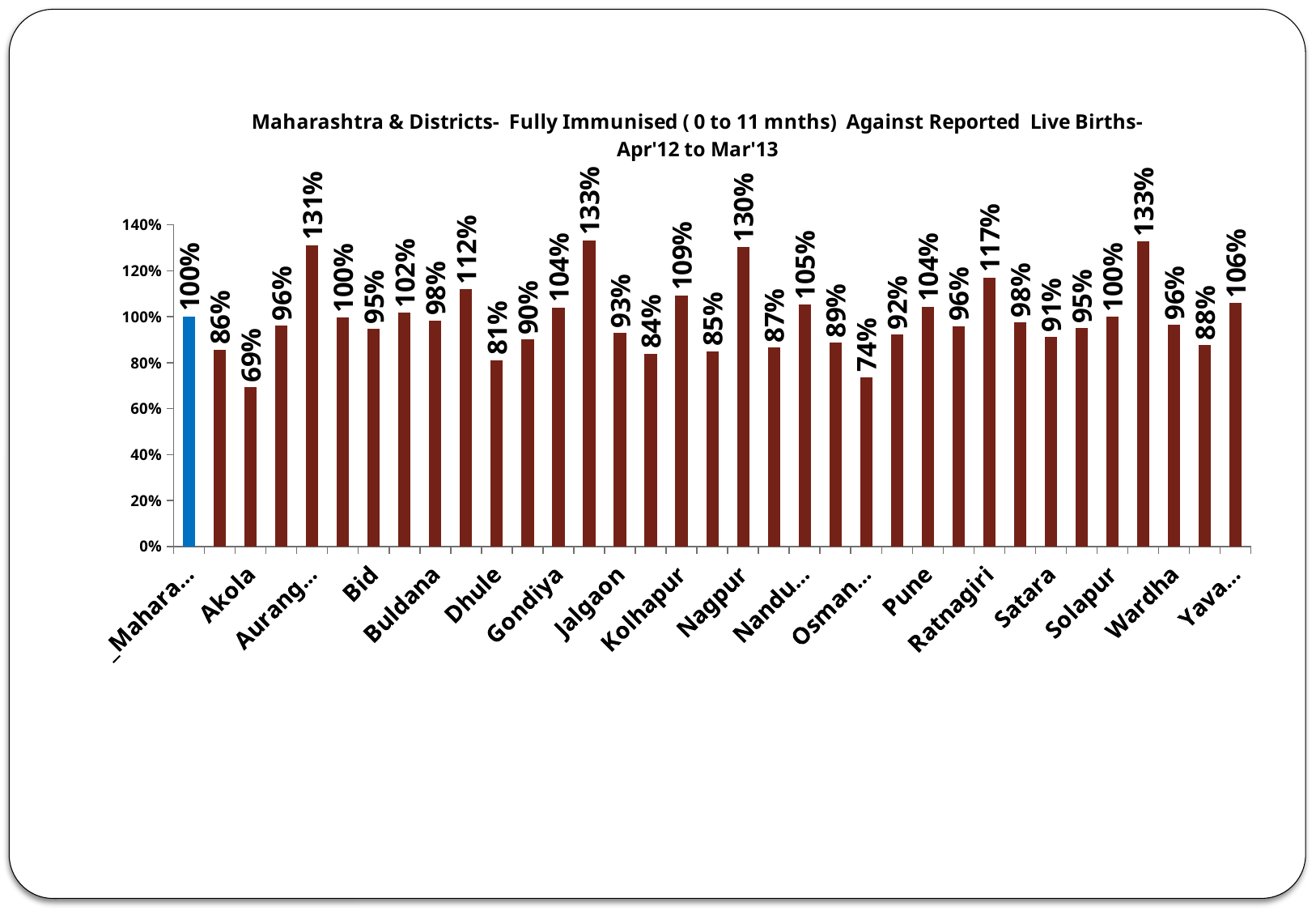
What is the difference between the values for Ratnagiri and Bid? 22% Is the value for Pune greater or less than 100%? greater What is the value for Dhule? 81% What is the value for Akola? 69% What is the value for Nagpur? 130% What colour is the bar for Maharashtra, the first bar? Blue What is the value for Solapur? 100% Which is larger, the value for Nagpur or the value for Kolhapur? Nagpur What is the difference between the values for Nagpur and Kolhapur? 21% What kind of chart is shown on the slide? Bar chart What is the value for Ratnagiri? 117% Which labelled district has the lowest value? Akola